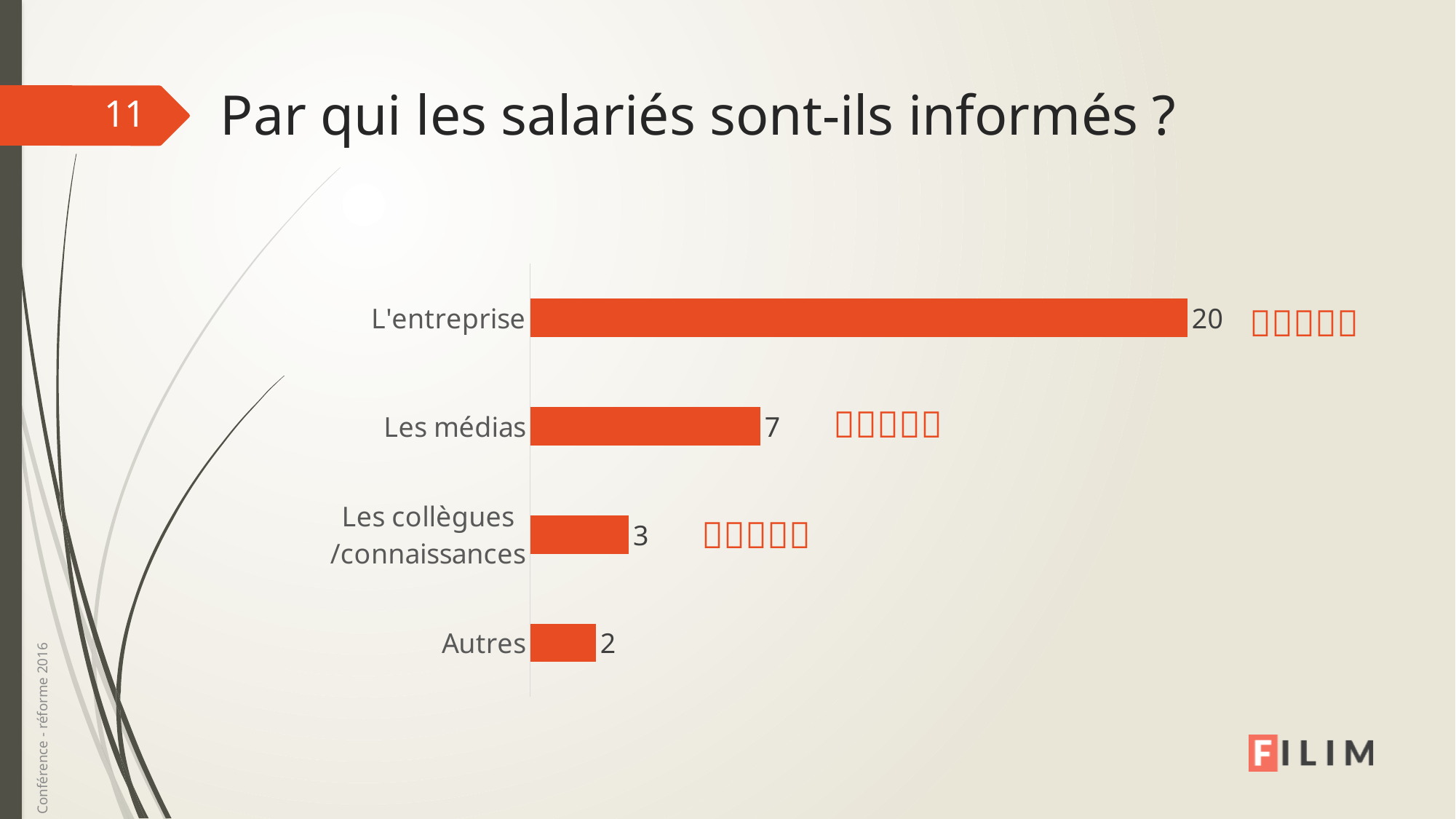
What is the difference between the values for Les médias and Autres? 5 What is the value for Autres? 2 Which category has the highest value? L'entreprise What is the value for Les médias? 7 What is the title of the slide containing the chart? Par qui les salariés sont-ils informés ? How many categories are shown in the chart? 4 What is the difference between the values for L'entreprise and Les médias? 13 What is the value for Les collègues /connaissances? 3 Which category has the lowest value? Autres What kind of chart is shown on the slide? Bar chart Which is larger, the value for Les médias or the value for Les collègues /connaissances? Les médias What is the value for L'entreprise? 20